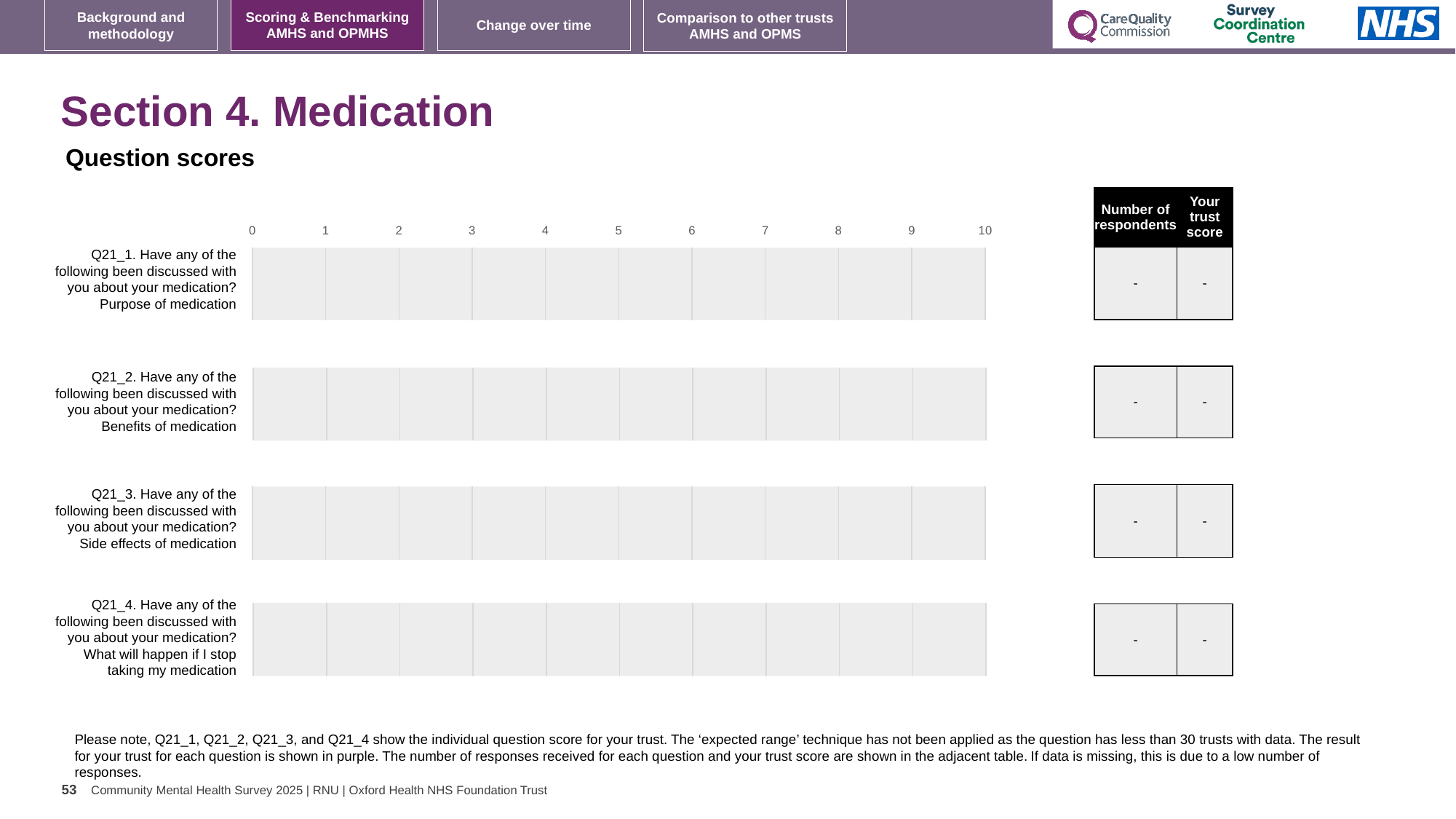
What is shown in the 'Number of respondents' column for Q21_4 (What will happen if I stop taking my medication)? - What kind of chart is used on this slide for the question scores? bar chart How many of the four questions have a bar plotted on the chart? 0 What is the highest value shown on the chart's horizontal axis? 10 What is shown in the 'Your trust score' column for Q21_3 (Side effects of medication)? - How many question categories are listed on the chart's vertical axis? 4 What is shown in the 'Number of respondents' column for Q21_2 (Benefits of medication)? - What is shown in the 'Your trust score' column for Q21_1 (Purpose of medication)? - What is the heading shown above the chart? Question scores